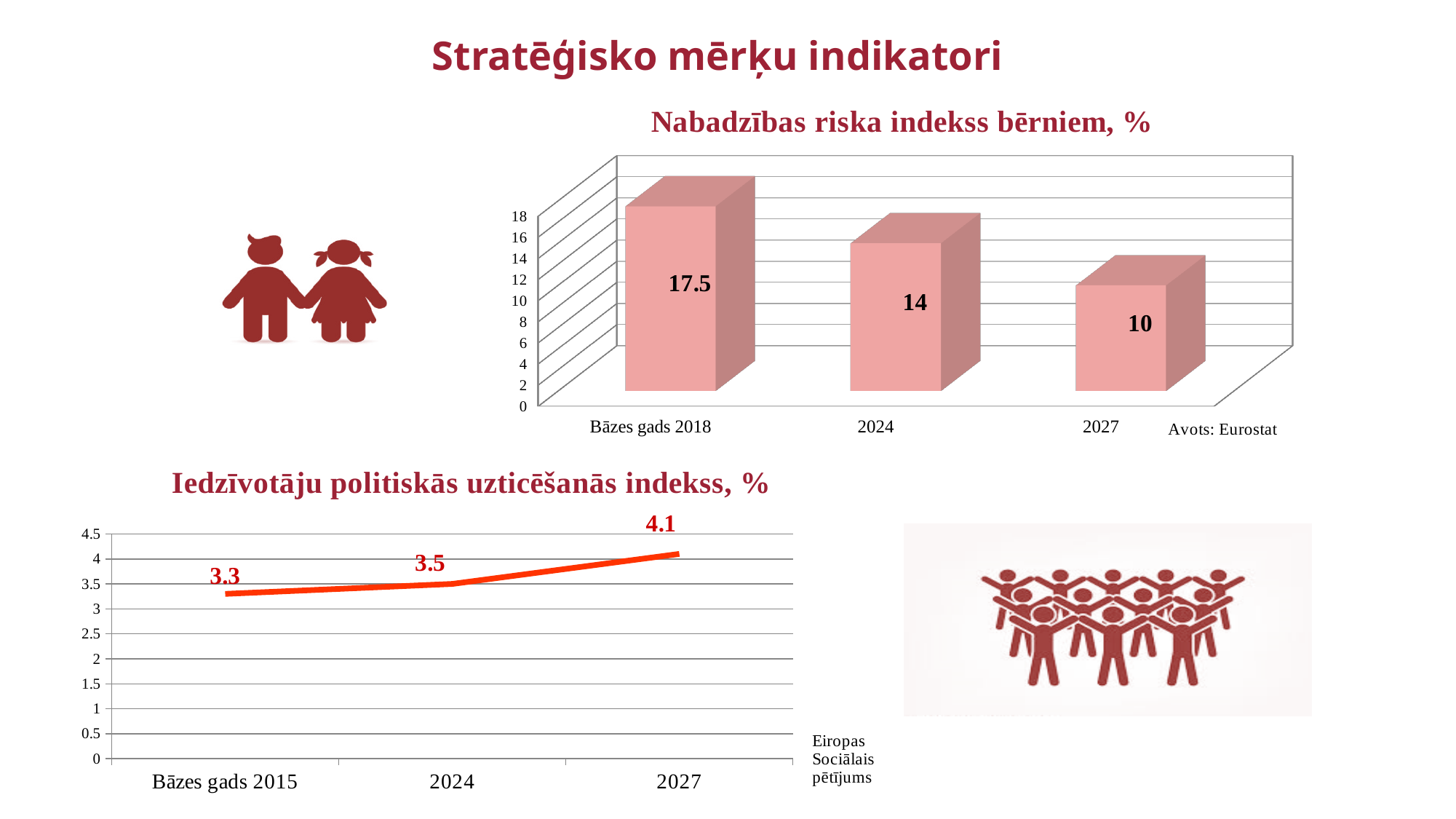
In the chart 'Iedzīvotāju politiskās uzticēšanās indekss, %', what is the difference between the values for 2027 and Bāzes gads 2015? 0.8 In the chart 'Nabadzības riska indekss bērniem, %', do the values rise or fall from Bāzes gads 2018 to 2027? fall What kind of chart is 'Nabadzības riska indekss bērniem, %'? bar chart In the chart 'Nabadzības riska indekss bērniem, %', what is the difference between the values for Bāzes gads 2018 and 2024? 3.5 How many bars are in the chart 'Nabadzības riska indekss bērniem, %'? 3 In the chart 'Nabadzības riska indekss bērniem, %', what is the value for 2027? 10 In the chart 'Iedzīvotāju politiskās uzticēšanās indekss, %', what is the value for 2024? 3.5 In the chart 'Iedzīvotāju politiskās uzticēšanās indekss, %', which point has the lowest value? Bāzes gads 2015 In the chart 'Nabadzības riska indekss bērniem, %', which category has the highest value? Bāzes gads 2018 In the chart 'Iedzīvotāju politiskās uzticēšanās indekss, %', what is the value for 2027? 4.1 What kind of chart is 'Iedzīvotāju politiskās uzticēšanās indekss, %'? line chart In the chart 'Nabadzības riska indekss bērniem, %', what is the value for Bāzes gads 2018? 17.5